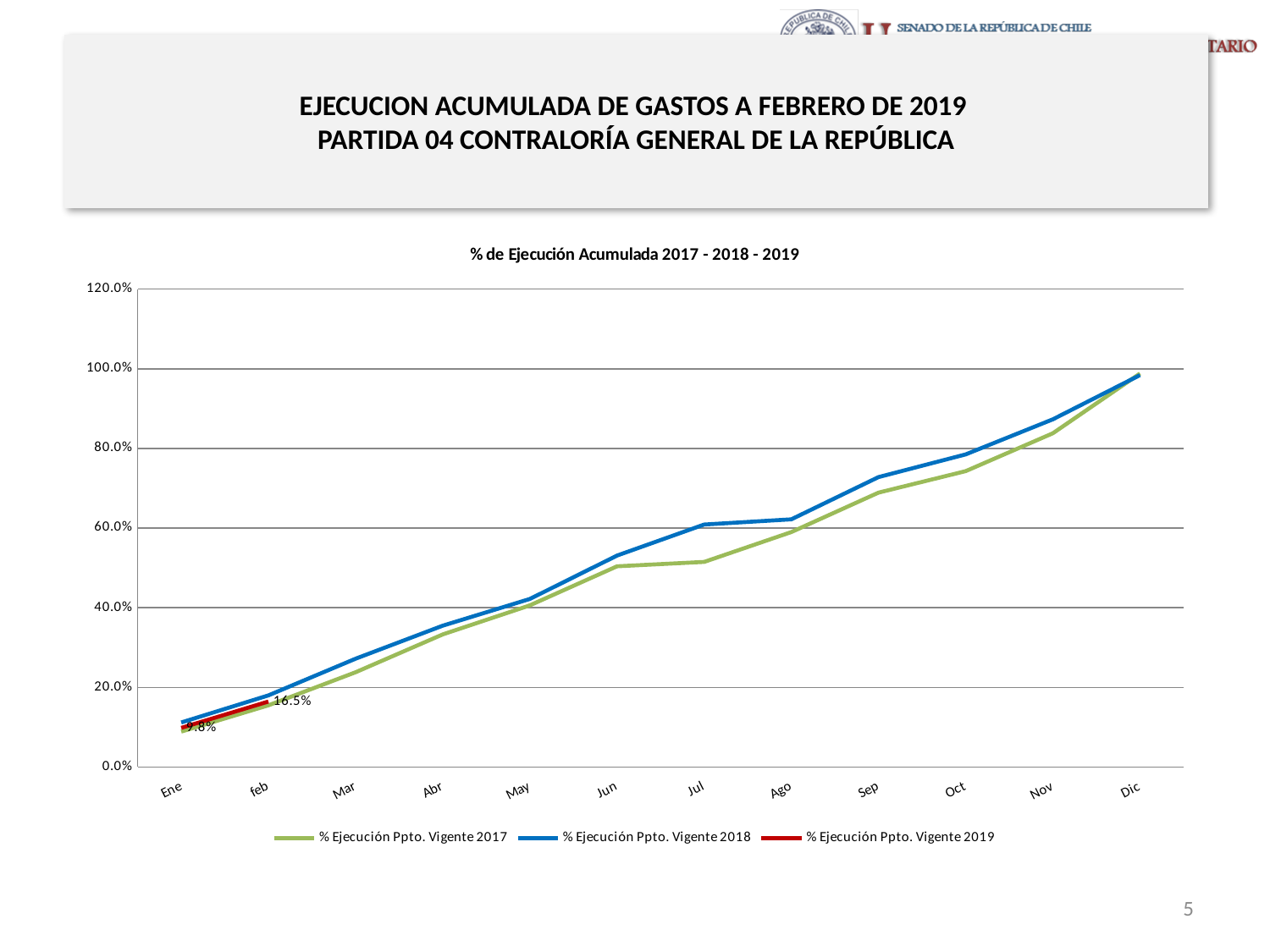
Is the value for % Ejecución Ppto. Vigente 2017 in Mar greater or less than 40.0%? less In Jul, which series is higher: % Ejecución Ppto. Vigente 2018 or % Ejecución Ppto. Vigente 2017? % Ejecución Ppto. Vigente 2018 What is the value of % Ejecución Ppto. Vigente 2019 in feb? 16.5% How many series does the legend list? 3 What is the title of the chart? % de Ejecución Acumulada 2017 - 2018 - 2019 By how much did % Ejecución Ppto. Vigente 2019 increase from Ene to feb? 6.7% How many months are shown along the x axis? 12 What is the value of % Ejecución Ppto. Vigente 2019 in Ene? 9.8% What type of chart is shown on the slide? line chart Do the values of % Ejecución Ppto. Vigente 2018 rise or fall from Ene to Dic? rise In which month is % Ejecución Ppto. Vigente 2018 at its lowest value? Ene In which month does % Ejecución Ppto. Vigente 2017 reach its highest value? Dic